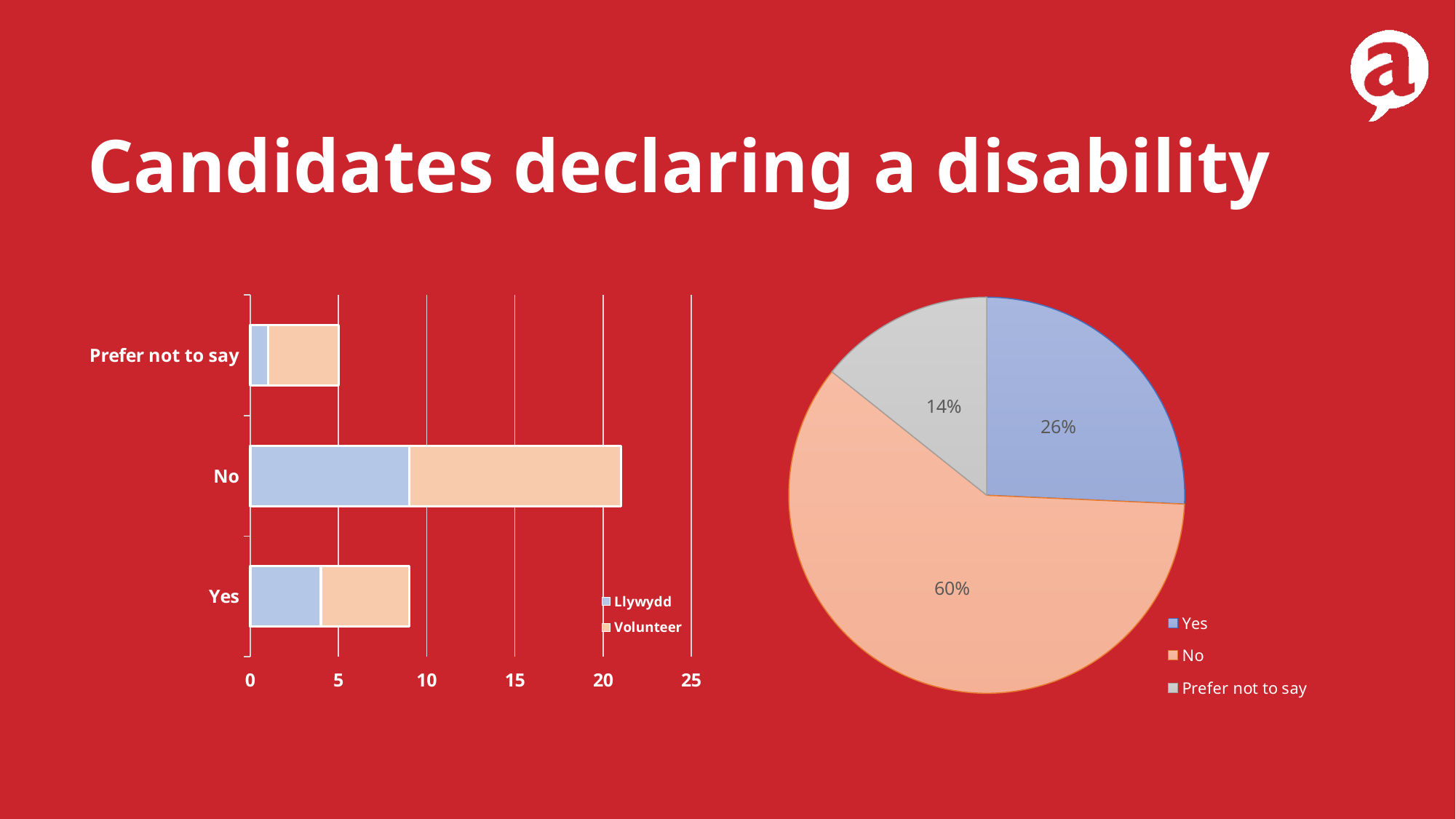
On the pie chart, how many percentage points larger is the No slice than the Yes slice? 34 On the bar chart on the left, how many series does the legend list? 2 On the bar chart on the left, is the total value for No greater or less than 20? greater On the pie chart, what share is labelled for Yes? 26% On the pie chart, which category has the smallest slice? Prefer not to say On the pie chart, which category has the largest slice? No On the bar chart on the left, is the total value for Yes greater or less than 10? less On the pie chart, what share is labelled for No? 60% On the pie chart, what share is labelled for Prefer not to say? 14% On the bar chart on the left, which category has the longest total bar? No On the pie chart, how many slices are there? 3 What kind of chart is the chart on the left of the slide? Bar chart